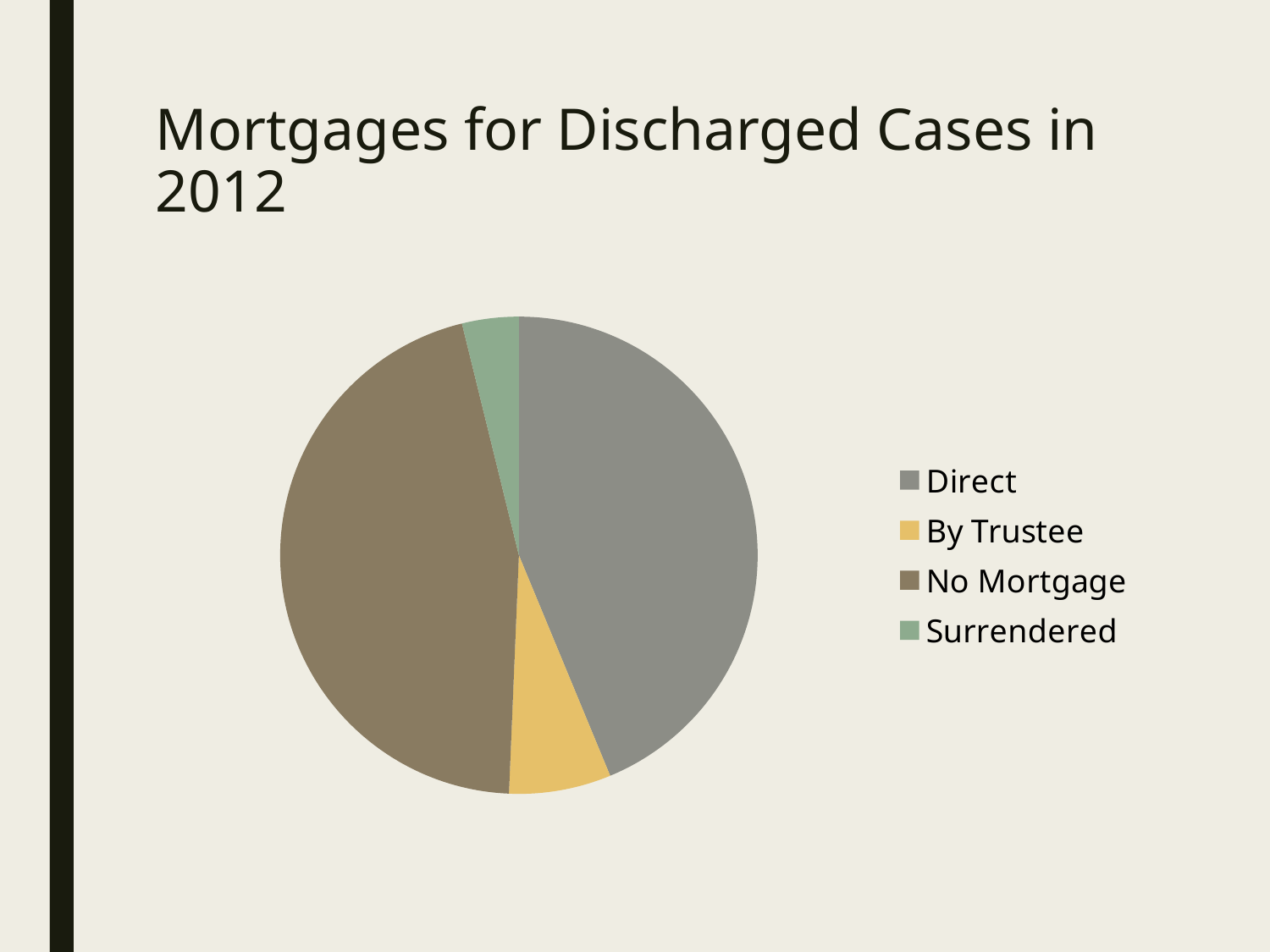
What is the title of the slide containing the chart? Mortgages for Discharged Cases in 2012 What kind of chart is shown on the slide? pie chart Which slice is larger, By Trustee or Surrendered? By Trustee Which category has the smallest slice of the pie? Surrendered Which slice is larger, Direct or By Trustee? Direct How many slices does the pie chart have? 4 Which slice is larger, No Mortgage or Surrendered? No Mortgage Which category is shown in yellow in the pie chart? By Trustee How many entries does the legend list? 4